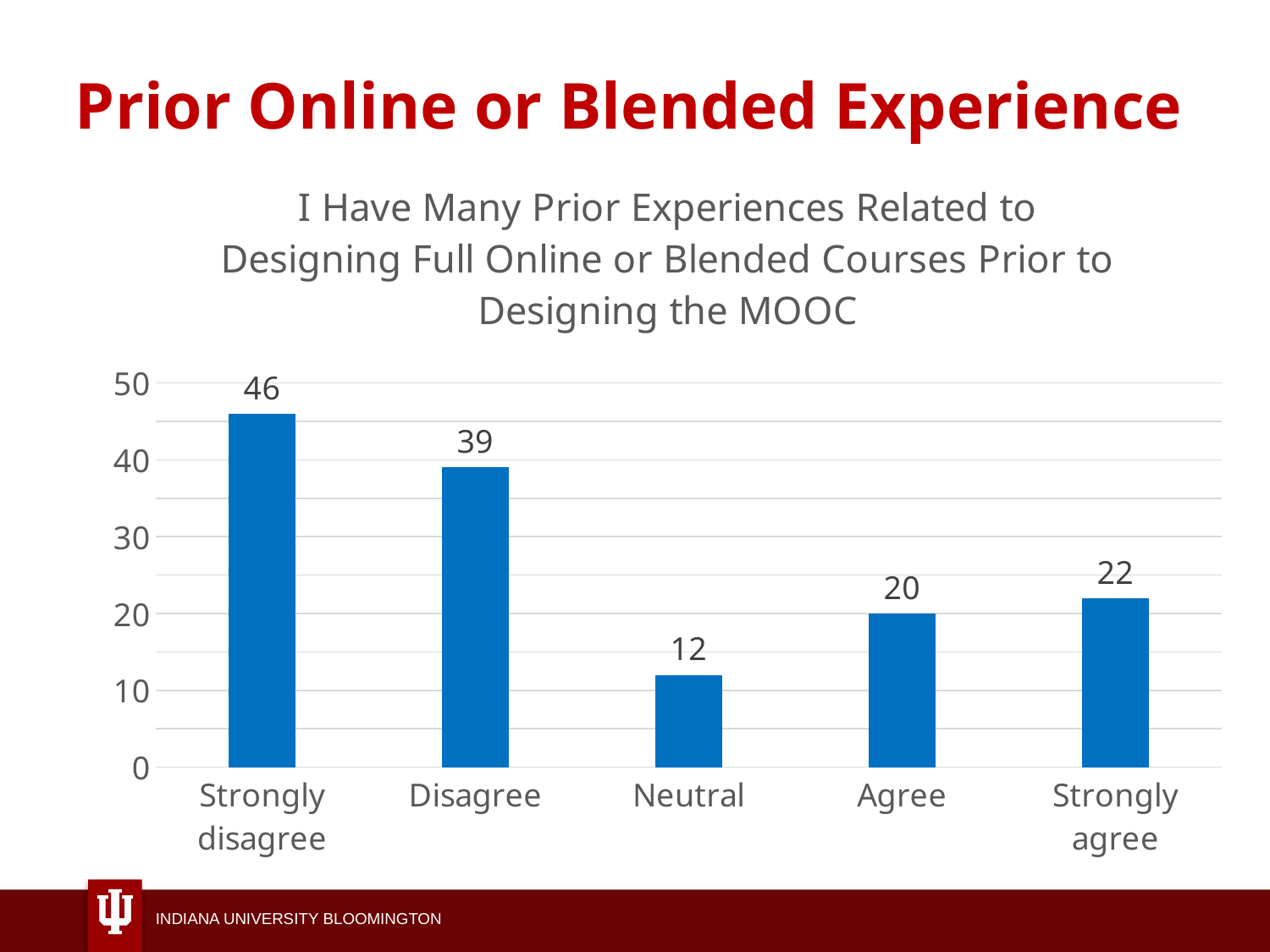
Which category has the highest value? Strongly disagree What is the difference between the values for Strongly agree and Agree? 2 What is the value for Strongly agree? 22 What is the value for Strongly disagree? 46 What is the difference between the values for Strongly disagree and Disagree? 7 What is the title of the chart? I Have Many Prior Experiences Related to Designing Full Online or Blended Courses Prior to Designing the MOOC Is the value for Disagree greater or less than 30? greater What kind of chart is shown on the slide? bar chart Which category has the lowest value? Neutral What is the value for Neutral? 12 Which is larger, the value for Disagree or the value for Agree? Disagree How many categories are shown on the x axis? 5